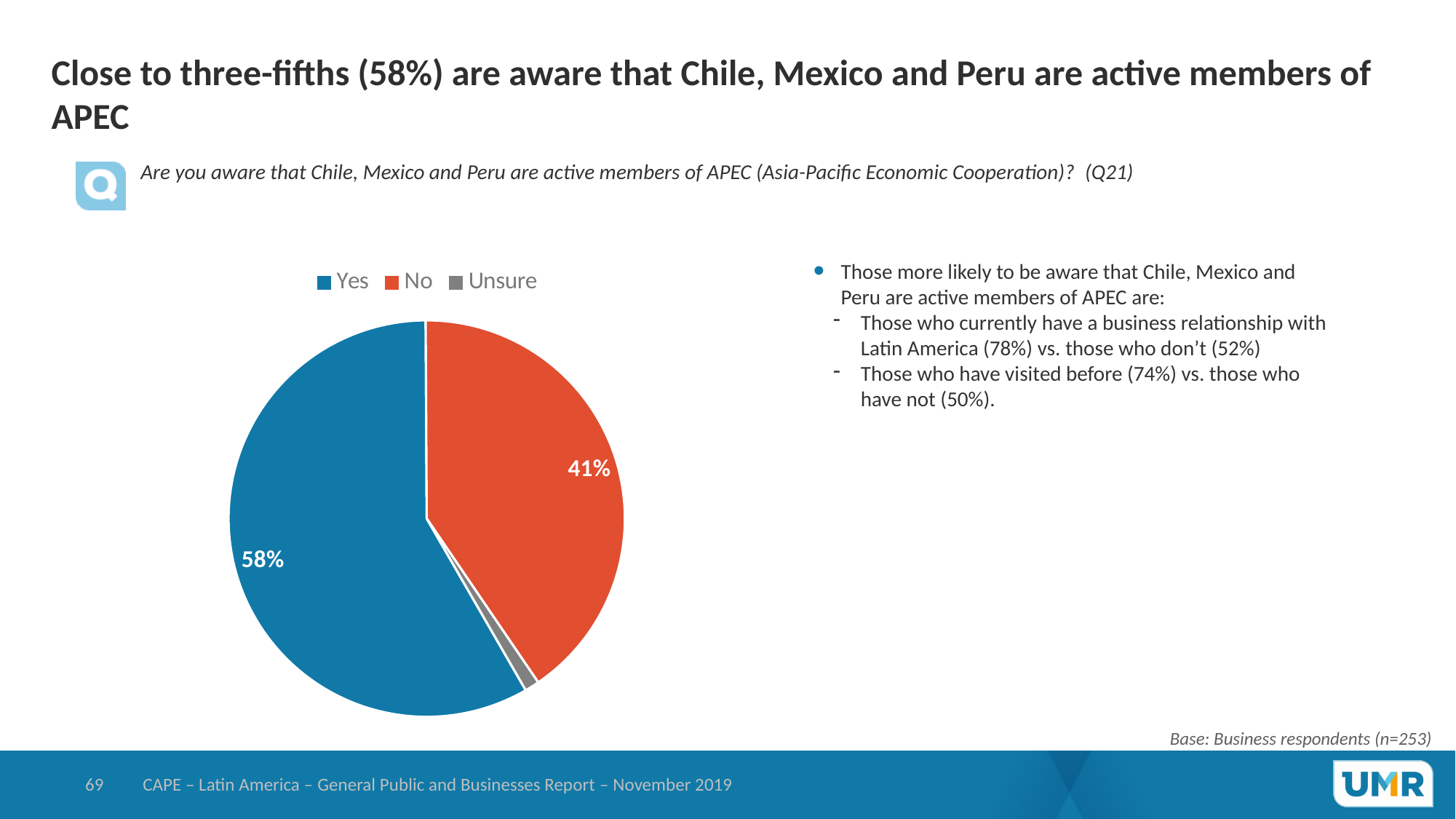
How many slices does the pie chart have? 3 How many series does the legend list? 3 Which response has the smallest share of the pie? Unsure What percentage of respondents answered No? 41% What is the difference in percentage points between the Yes and No shares? 17 What percentage of respondents answered Yes? 58% Which response has the largest share of the pie? Yes What colour is the Yes slice? Blue What colour is the Unsure slice? Grey Which is larger, the Yes share or the No share? Yes What kind of chart is shown on the slide? Pie chart